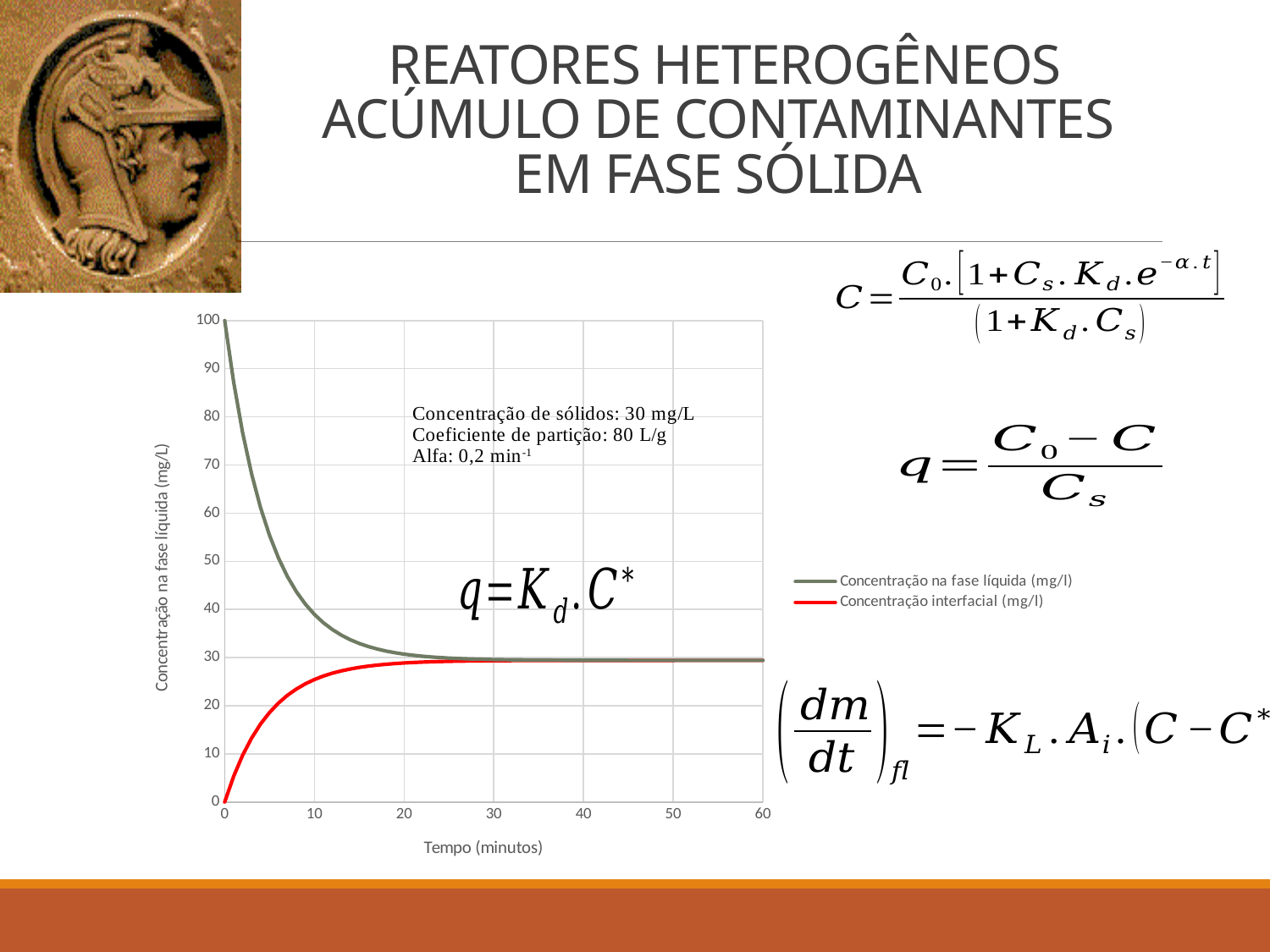
Is the value of 'Concentração na fase líquida (mg/l)' at 10 minutes greater or less than 50? less Does the 'Concentração na fase líquida (mg/l)' series rise or fall as time increases? fall What kind of chart is shown on the slide? line chart What is the title of the x axis of the chart? Tempo (minutos) What is the value of 'Concentração interfacial (mg/l)' at time 0 minutes? 0 What is the value of 'Concentração na fase líquida (mg/l)' at time 0 minutes? 100 Is the value of 'Concentração interfacial (mg/l)' at 10 minutes greater or less than 20? greater Which series has the highest value on the chart? Concentração na fase líquida (mg/l) Does the 'Concentração interfacial (mg/l)' series rise or fall as time increases? rise How many series does the chart legend list? 2 At 5 minutes, which series has the higher value: 'Concentração na fase líquida (mg/l)' or 'Concentração interfacial (mg/l)'? Concentração na fase líquida (mg/l) What colour is the line for 'Concentração interfacial (mg/l)'? red